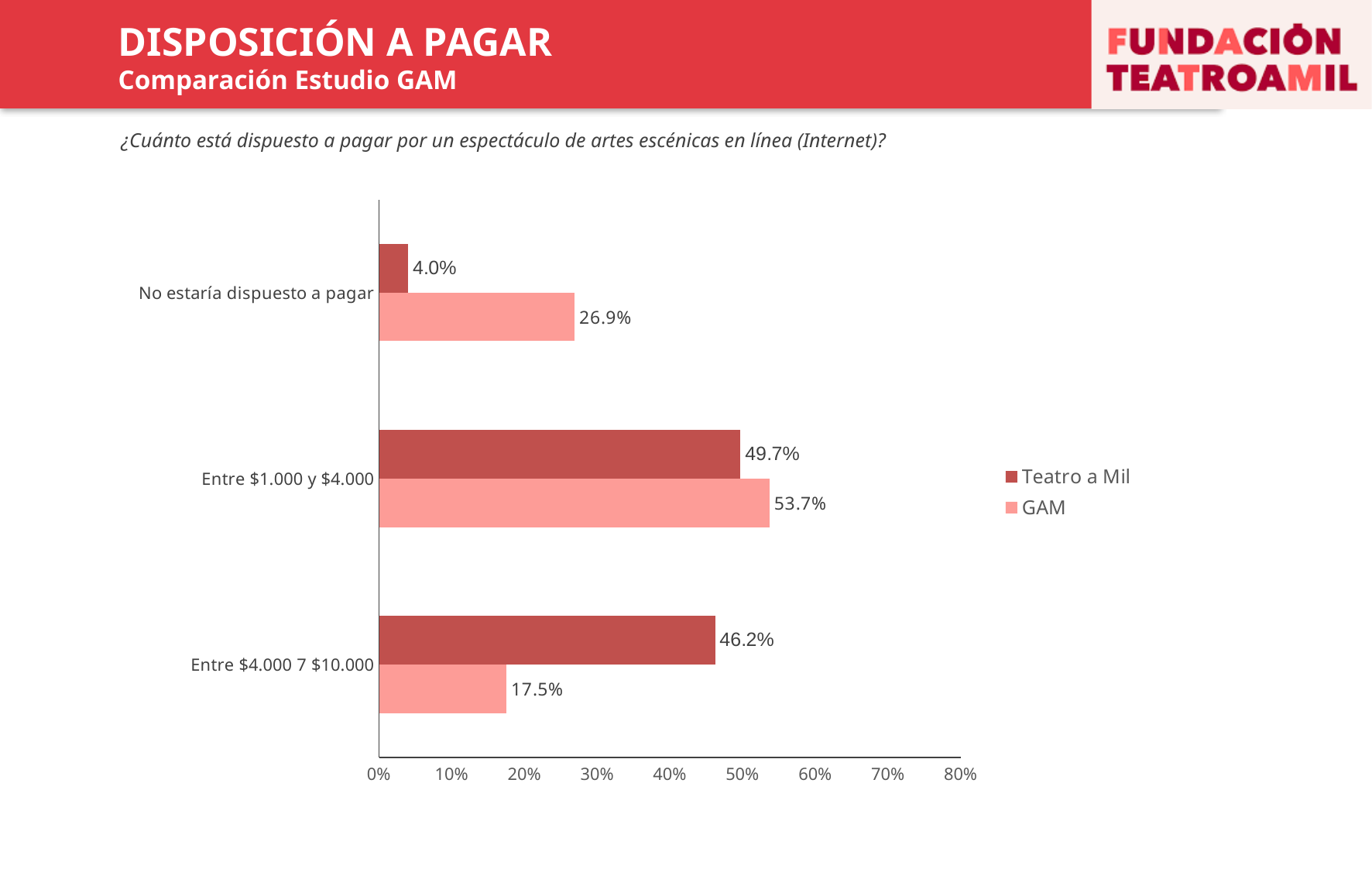
How many categories are shown on the chart? 3 What kind of chart is shown on the slide? Bar chart What is the GAM value for "Entre $1.000 y $4.000"? 53.7% For "No estaría dispuesto a pagar", which series has the larger value, Teatro a Mil or GAM? GAM What is the GAM value for "No estaría dispuesto a pagar"? 26.9% What is the difference between the GAM and Teatro a Mil values for "Entre $4.000 7 $10.000"? 28.7% Which category has the lowest Teatro a Mil value? No estaría dispuesto a pagar What is the Teatro a Mil value for "No estaría dispuesto a pagar"? 4.0% What is the Teatro a Mil value for "Entre $4.000 7 $10.000"? 46.2% Is the Teatro a Mil value for "Entre $1.000 y $4.000" greater or less than 40%? greater Which category has the highest GAM value? Entre $1.000 y $4.000 How many series does the legend list? 2